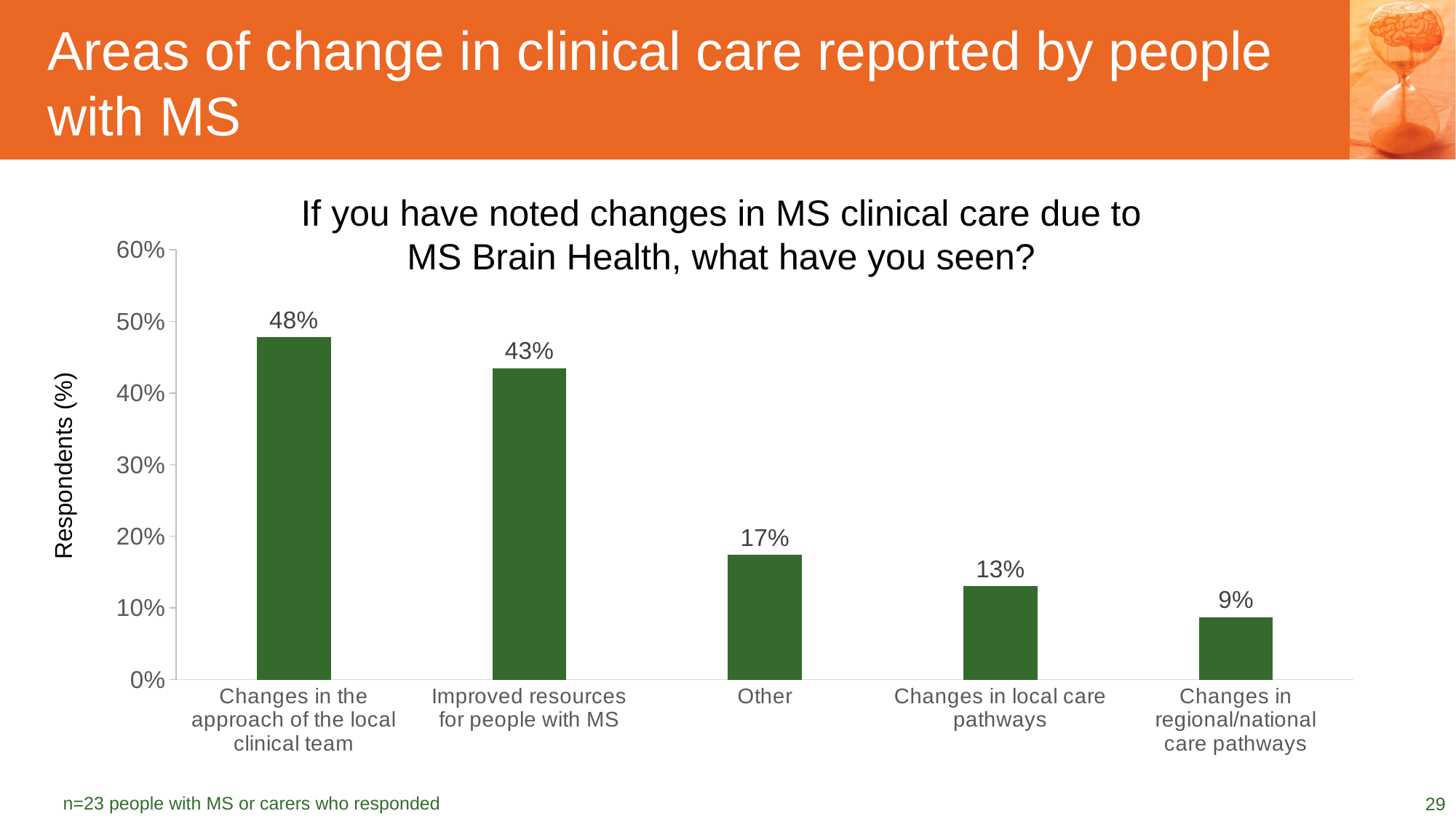
What is the difference in percentage points between 'Changes in the approach of the local clinical team' and 'Improved resources for people with MS'? 5 percentage points How many categories are shown on the x axis? 5 Is the value for 'Changes in local care pathways' greater or less than 20%? less Which category has the lowest percentage of respondents? Changes in regional/national care pathways Which category has the highest percentage of respondents? Changes in the approach of the local clinical team What percentage of respondents reported 'Changes in regional/national care pathways'? 9% What percentage of respondents reported 'Improved resources for people with MS'? 43% What is the label of the y axis? Respondents (%) What kind of chart is shown on the slide? Bar chart Which is larger: the value for 'Other' or the value for 'Changes in local care pathways'? Other What is the value for the 'Other' category? 17% What percentage of respondents reported 'Changes in the approach of the local clinical team'? 48%